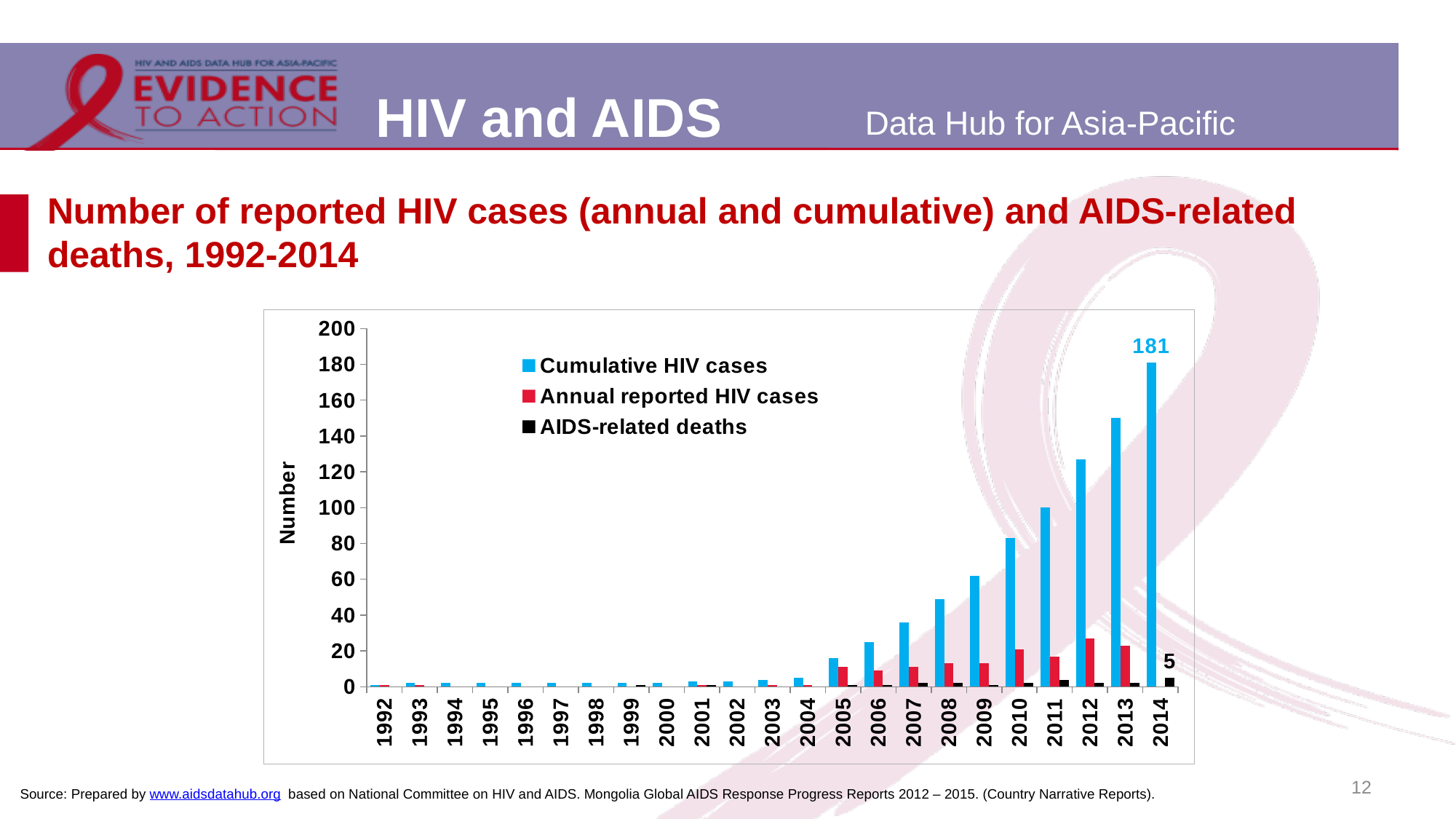
Is the value for Cumulative HIV cases in 2013 greater or less than 120? greater How many years are shown on the x axis? 23 What is the value of Cumulative HIV cases in 2014? 181 What is the difference between Cumulative HIV cases and AIDS-related deaths in 2014? 176 Do Cumulative HIV cases rise or fall from 1992 to 2014? Rise Is the value for Annual reported HIV cases in 2012 greater or less than 20? greater What is the value of AIDS-related deaths in 2014? 5 Is the value for Cumulative HIV cases in 2009 greater or less than 40? greater What kind of chart is shown on the slide? Bar chart In 2014, which is larger: Cumulative HIV cases or AIDS-related deaths? Cumulative HIV cases How many series does the legend list? 3 In which year are Cumulative HIV cases highest? 2014